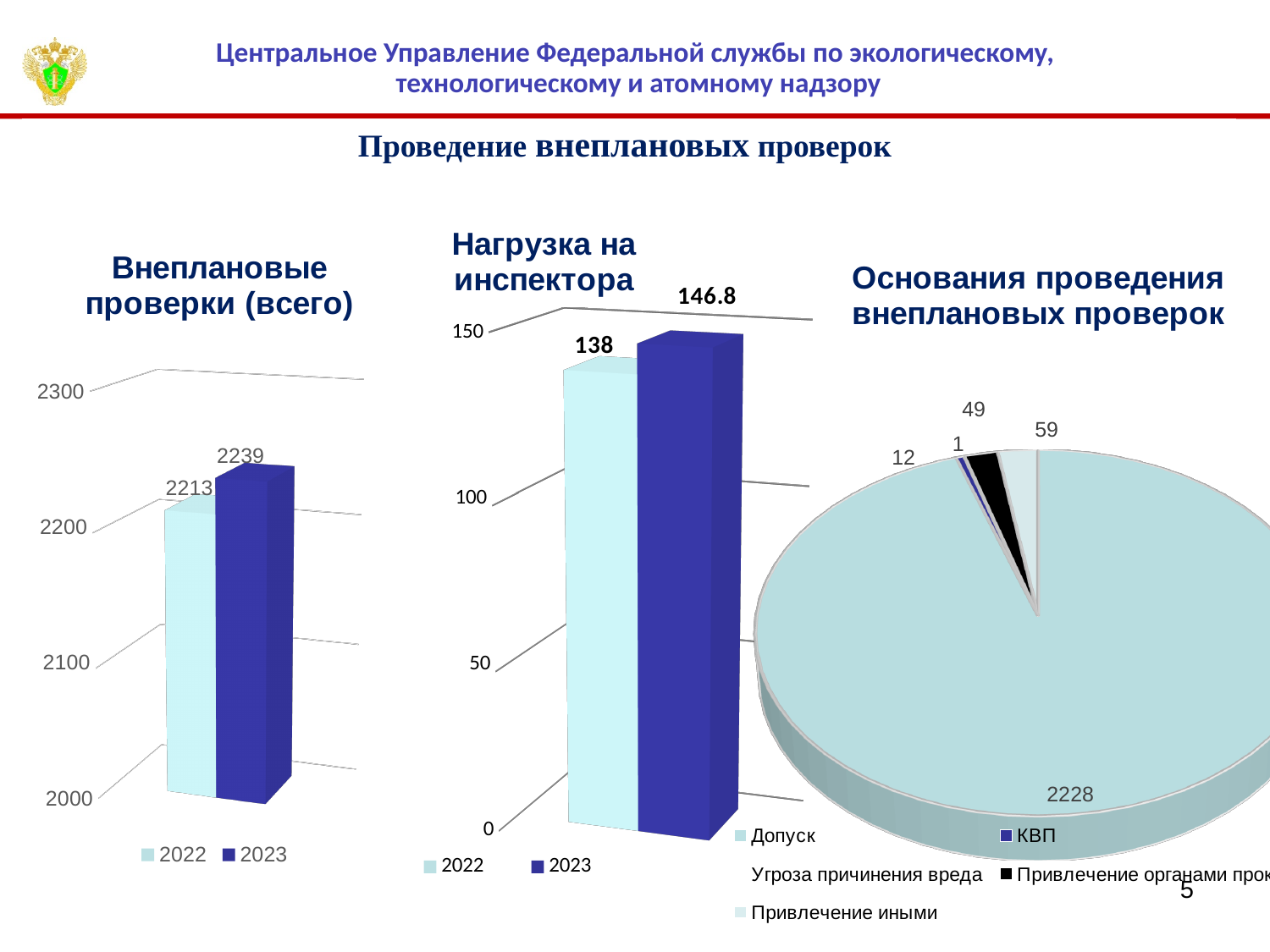
In the chart 'Внеплановые проверки (всего)', what is the value for 2022? 2213 What kind of chart is 'Основания проведения внеплановых проверок'? pie chart In the chart 'Нагрузка на инспектора', what is the value for 2023? 146.8 In the chart 'Основания проведения внеплановых проверок', what is the value of the 'Допуск' slice? 2228 In the chart 'Внеплановые проверки (всего)', what is the value for 2023? 2239 How many series does the legend of the chart 'Внеплановые проверки (всего)' list? 2 What kind of chart is 'Нагрузка на инспектора'? bar chart In the chart 'Внеплановые проверки (всего)', by how much does the 2023 value exceed the 2022 value? 26 In the chart 'Нагрузка на инспектора', what is the difference between the 2023 and 2022 values? 8.8 In the chart 'Нагрузка на инспектора', what is the value for 2022? 138 In the chart 'Нагрузка на инспектора', is the value for 2022 greater or less than 100? greater In the chart 'Нагрузка на инспектора', which year has the higher value, 2022 or 2023? 2023